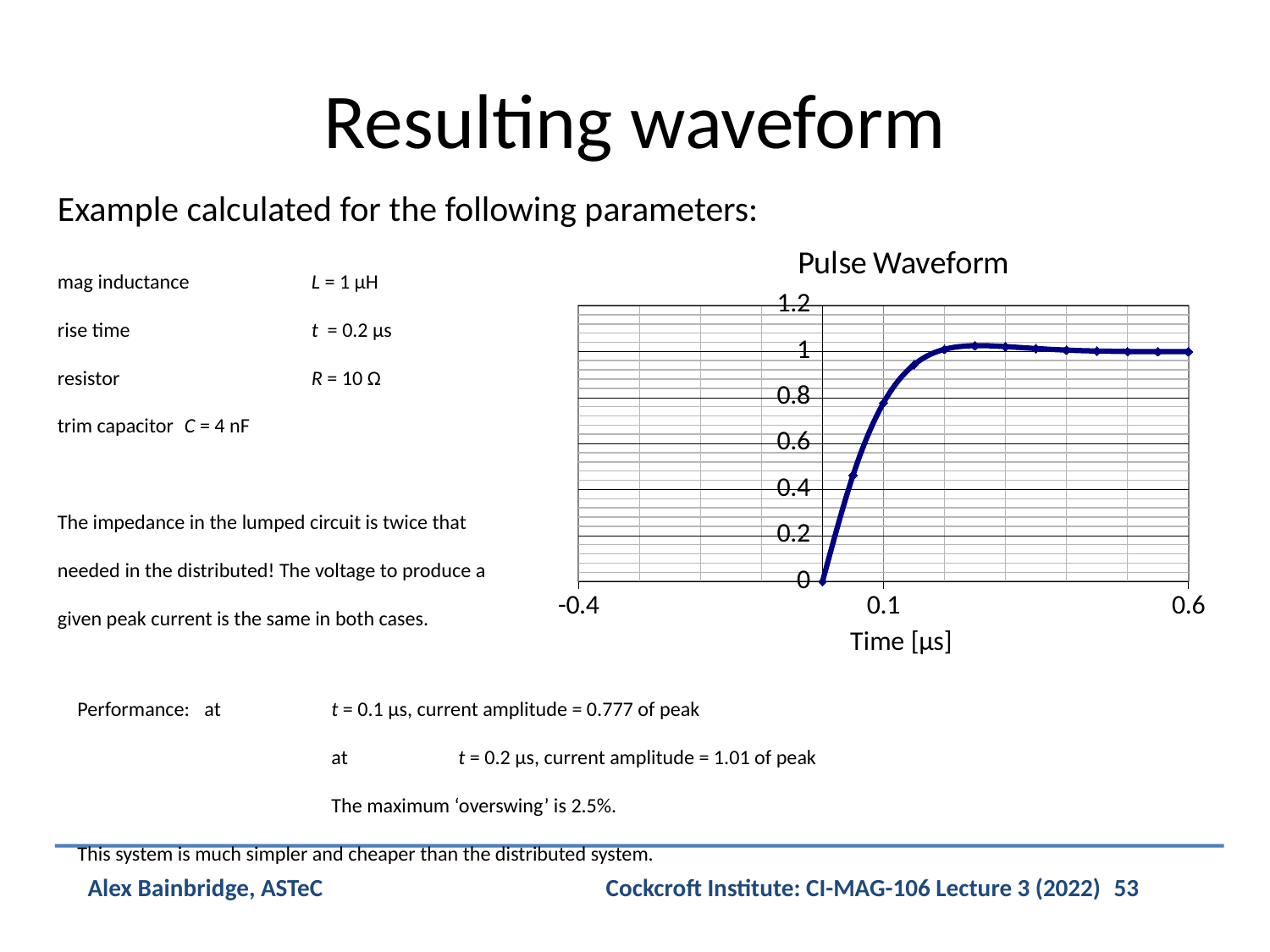
Is the value of the waveform at time 0.1 μs greater or less than 0.6? greater Is the value of the waveform at time 0.6 μs greater or less than 0.8? greater Does the waveform rise or fall between time 0 and time 0.1 μs? rise Is the value of the waveform at time 0.6 μs greater or less than 1.2? less What is the label of the x axis of the chart? Time [μs] What is the highest value shown on the y axis of the chart? 1.2 What is the title of the chart? Pulse Waveform What kind of chart is shown on the slide? line chart